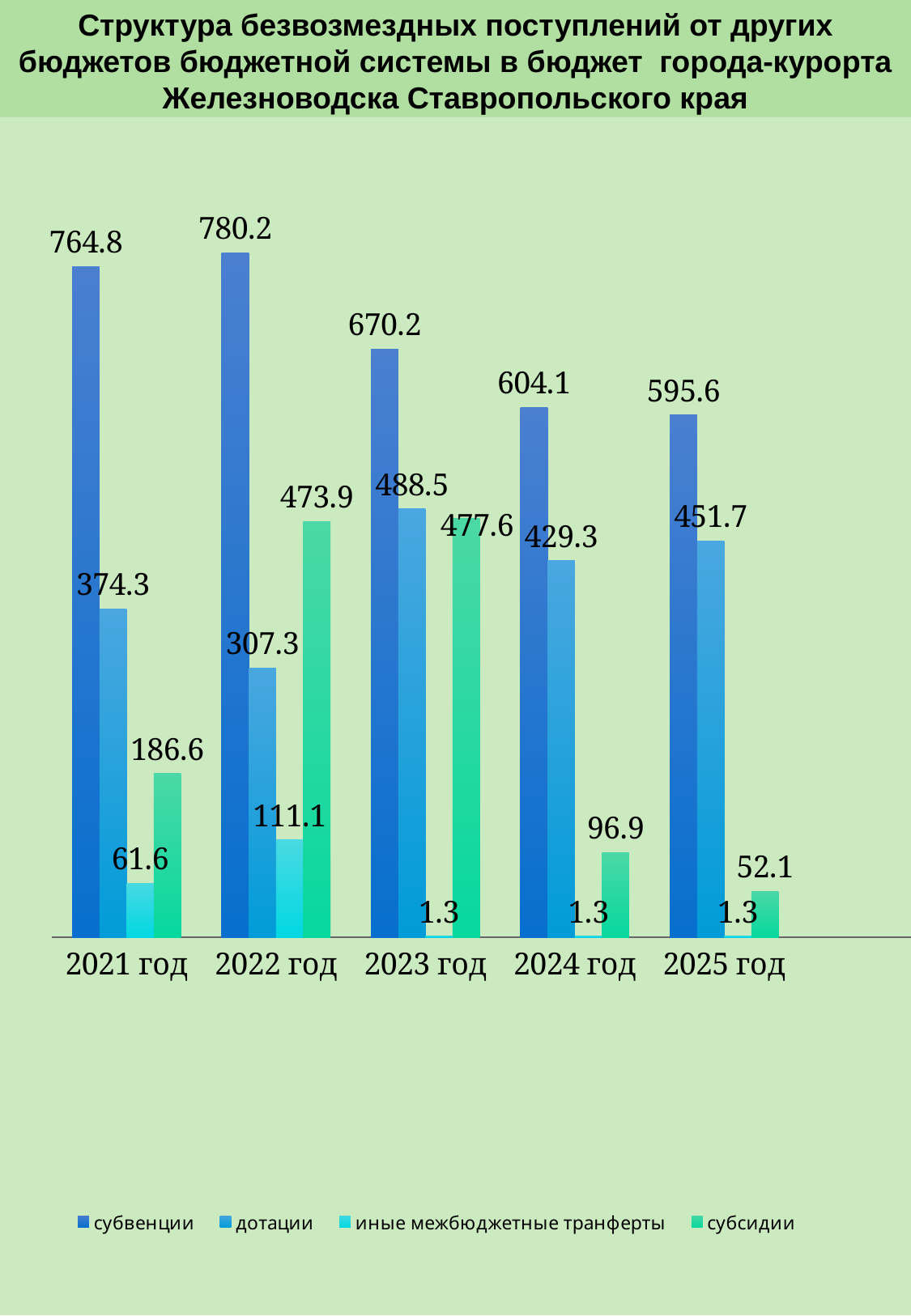
In which year is the value for субсидии the lowest? 2025 год What is the value for субвенции in 2022 год? 780.2 What kind of chart is shown on the slide? bar chart What is the difference between the субвенции values for 2021 год and 2025 год? 169.2 What is the value for субсидии in 2021 год? 186.6 Which is larger in 2023 год: дотации or субсидии? дотации What is the value for дотации in 2023 год? 488.5 Do the values for субвенции rise or fall from 2022 год to 2025 год? fall In which year is the value for субвенции the highest? 2022 год How many series does the legend list? 4 What is the value for иные межбюджетные трансферты in 2022 год? 111.1 How many years are shown on the x axis? 5